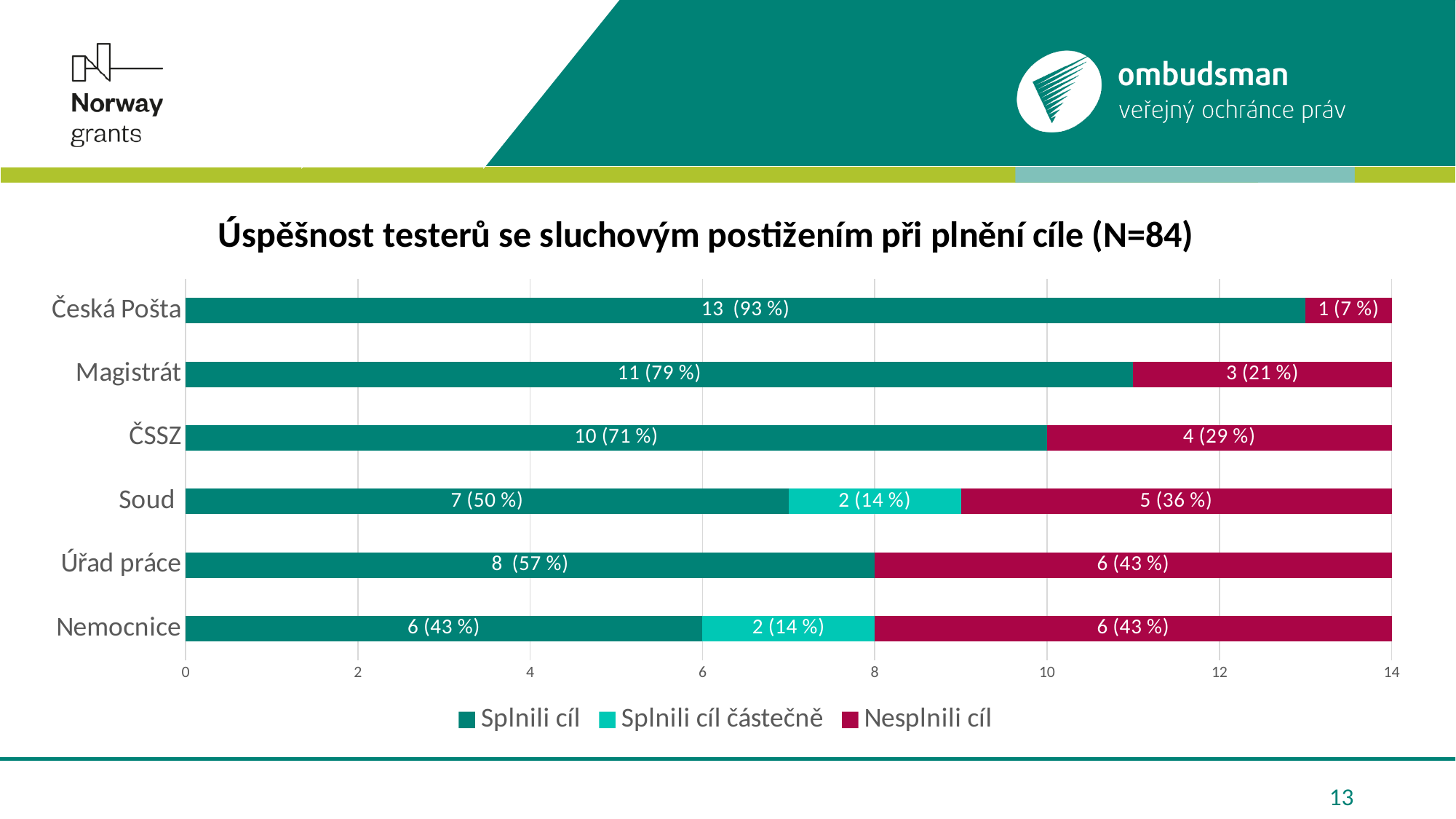
Which category has the lowest 'Splnili cíl' value? Nemocnice Which is larger: the 'Nesplnili cíl' count for Soud or for ČSSZ? Soud How many series does the legend list? 3 What is the data label for 'Splnili cíl částečně' for Soud? 2 (14 %) What is the title of the chart? Úspěšnost testerů se sluchovým postižením při plnění cíle (N=84) How many categories are shown on the y axis? 6 What type of chart is shown on the slide? stacked bar chart What is the total of the stacked bar for Nemocnice? 14 What is the difference between the 'Splnili cíl' counts for Magistrát and ČSSZ? 1 What is the data label for 'Splnili cíl' for Česká Pošta? 13 (93 %) Which category has the highest 'Splnili cíl' value? Česká Pošta What is the data label for 'Nesplnili cíl' for Úřad práce? 6 (43 %)